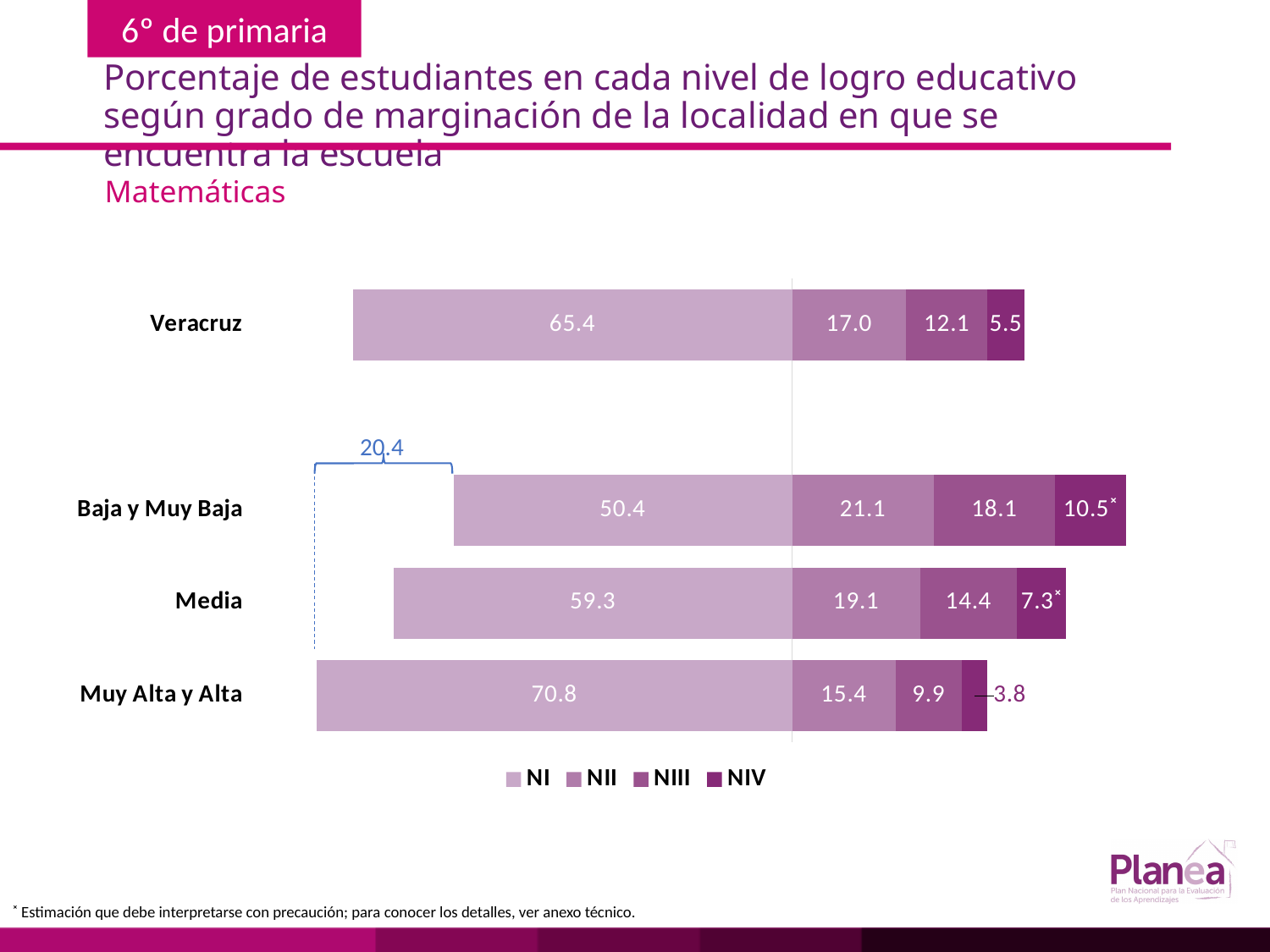
Which category has the highest NI value? Muy Alta y Alta What is the NII value for Media? 19.1 How many series does the legend list? 4 What are the legend entries of the chart? NI, NII, NIII, NIV What kind of chart is shown on the slide? Stacked bar chart What is the NI value for Veracruz? 65.4 What is the difference between the NI values for Muy Alta y Alta and Baja y Muy Baja? 20.4 Which category has the lowest NIV value? Muy Alta y Alta How many categories are shown on the chart? 4 Which is larger, the NII value for Baja y Muy Baja or the NII value for Veracruz? Baja y Muy Baja What is the NIV value for Baja y Muy Baja? 10.5 What is the NIII value for Muy Alta y Alta? 9.9